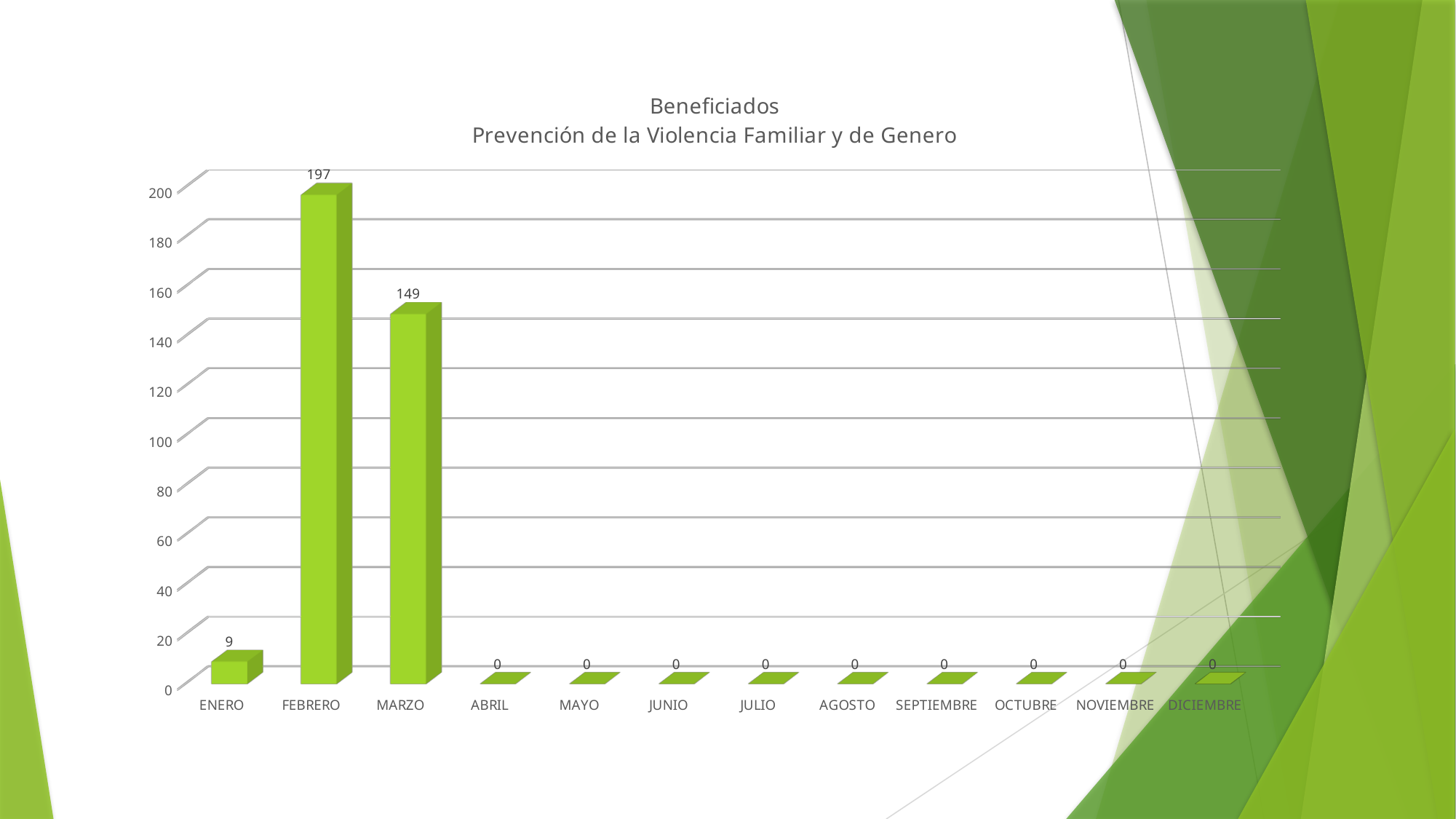
What is the value for ENERO? 9 What is the value for MARZO? 149 What is the value for ABRIL? 0 Is the value for FEBRERO greater or less than 180? greater What is the value for FEBRERO? 197 What is the title of the chart? Beneficiados Prevención de la Violencia Familiar y de Genero What kind of chart is this? bar chart What is the difference between the values for MARZO and ENERO? 140 Which month has the highest value? FEBRERO What is the difference between the values for FEBRERO and MARZO? 48 How many months are shown on the x axis? 12 Which is larger, the value for ENERO or the value for MARZO? MARZO